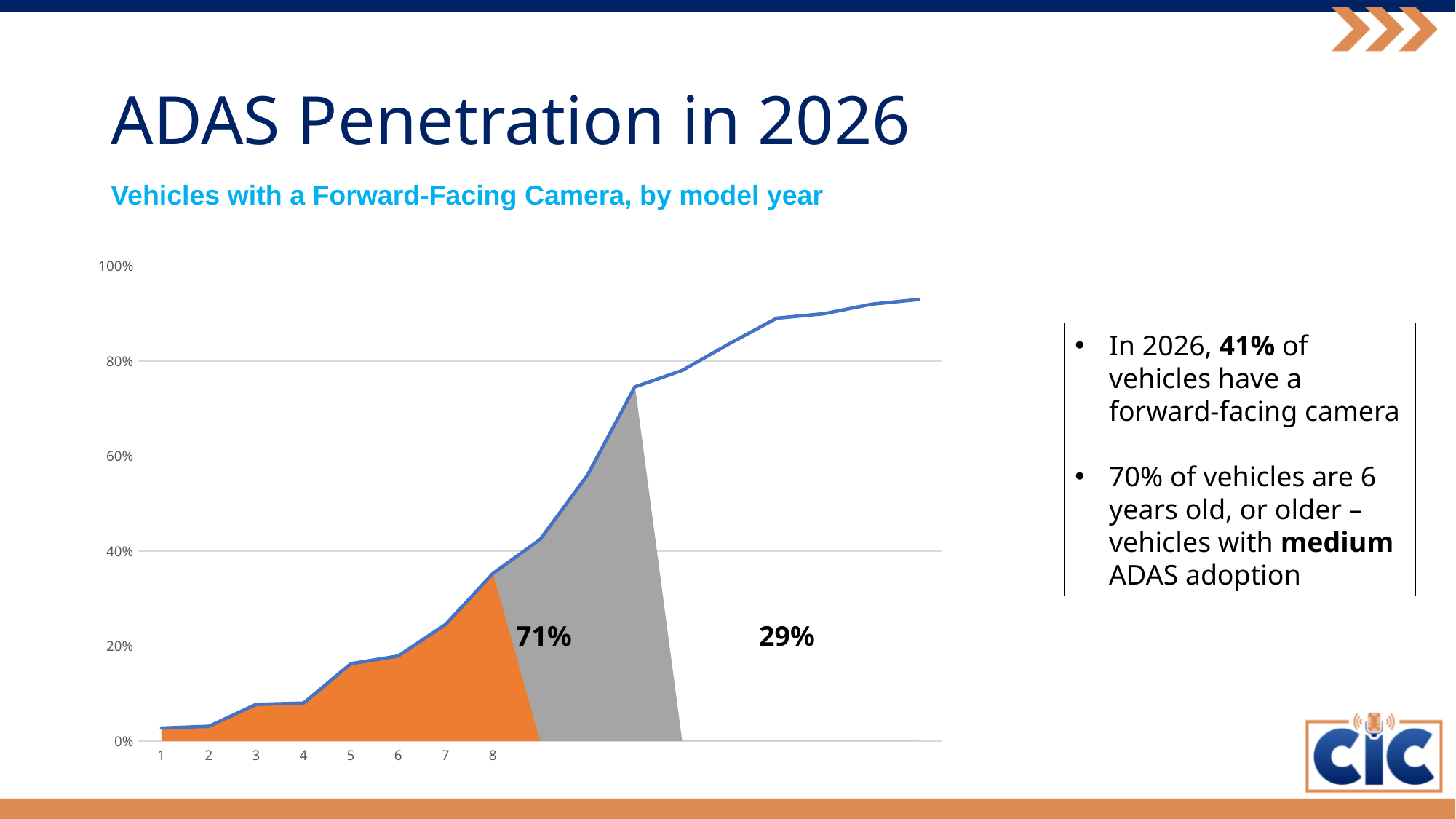
Which of the labelled model years, 1 or 8, has the lower value? 1 What kind of chart is shown on the slide? line chart with shaded areas Is the value at model year 7 greater or less than 20%? greater Is the value at model year 8 greater or less than 40%? less Do the values rise or fall as you move from left to right along the x axis? rise How many model-year labels are shown on the x axis? 8 Is the value at model year 5 greater or less than 20%? less What is the title of the chart? Vehicles with a Forward-Facing Camera, by model year What is the highest value shown on the y axis? 100%